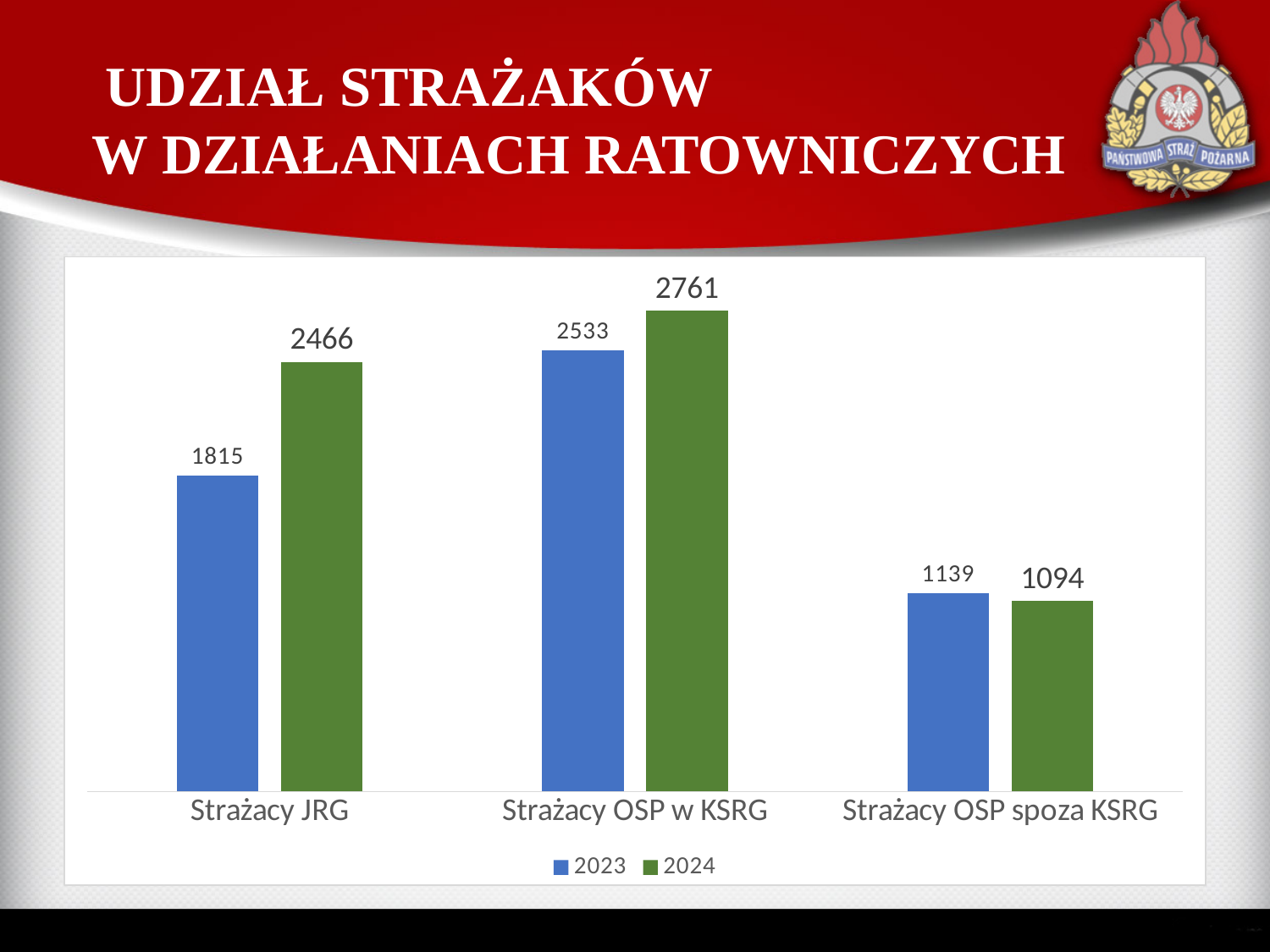
Which category has the highest value in 2024? Strażacy OSP w KSRG What is the value for Strażacy OSP spoza KSRG in 2023? 1139 Which category has the lowest value in 2023? Strażacy OSP spoza KSRG Which is larger for Strażacy OSP w KSRG, the 2023 value or the 2024 value? 2024 Which colour represents the 2024 series in the legend? green How many series does the legend list? 2 What kind of chart is shown on the slide? bar chart What is the value for Strażacy OSP w KSRG in 2024? 2761 What is the difference between the 2024 and 2023 values for Strażacy JRG? 651 How many categories are shown on the x axis? 3 What is the difference between the 2023 and 2024 values for Strażacy OSP spoza KSRG? 45 What is the value for Strażacy JRG in 2023? 1815